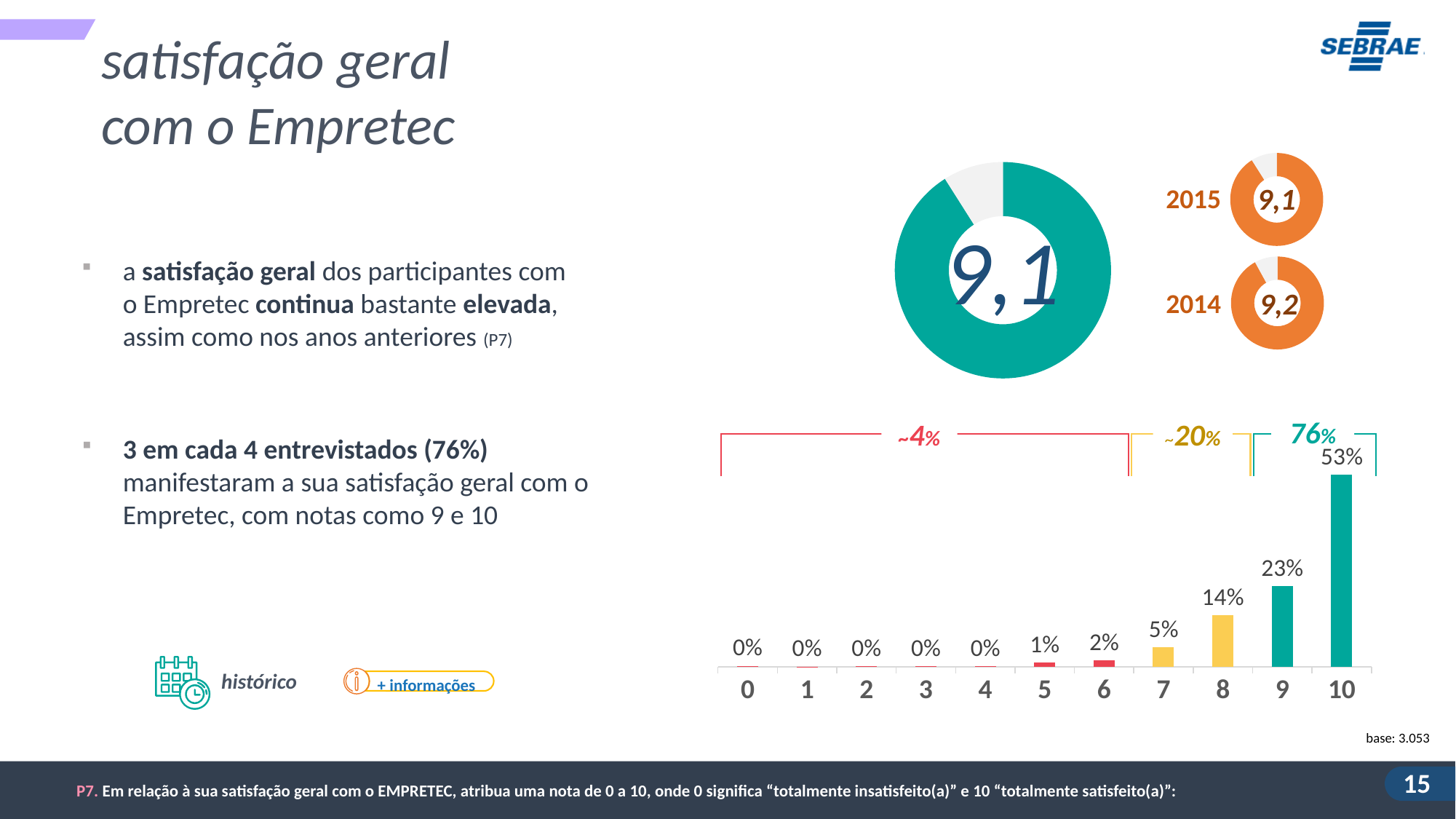
In the bar chart of satisfaction scores, do the percentages rise or fall as the score increases from 5 to 10? Rise In the bar chart of satisfaction scores, what is the difference in percentage points between scores 10 and 9? 30 In the large teal donut chart, what is the average overall satisfaction score shown? 9,1 In the bar chart of satisfaction scores, what percentage of respondents gave a score of 7? 5% In the bar chart of satisfaction scores, which has a larger percentage: score 6 or score 8? Score 8 In the bar chart of satisfaction scores, what percentage of respondents gave a score of 8? 14% How many score categories are shown on the x axis of the bar chart? 11 In the bar chart, what is the combined percentage shown above the bracket for scores 9 and 10? 76% What type of chart shows the distribution of satisfaction scores from 0 to 10? Bar chart In the bar chart of satisfaction scores, what percentage of respondents gave a score of 10? 53% In the small orange donut chart for 2014, what average satisfaction score is shown? 9,2 In the bar chart of satisfaction scores, which score has the highest percentage of respondents? 10